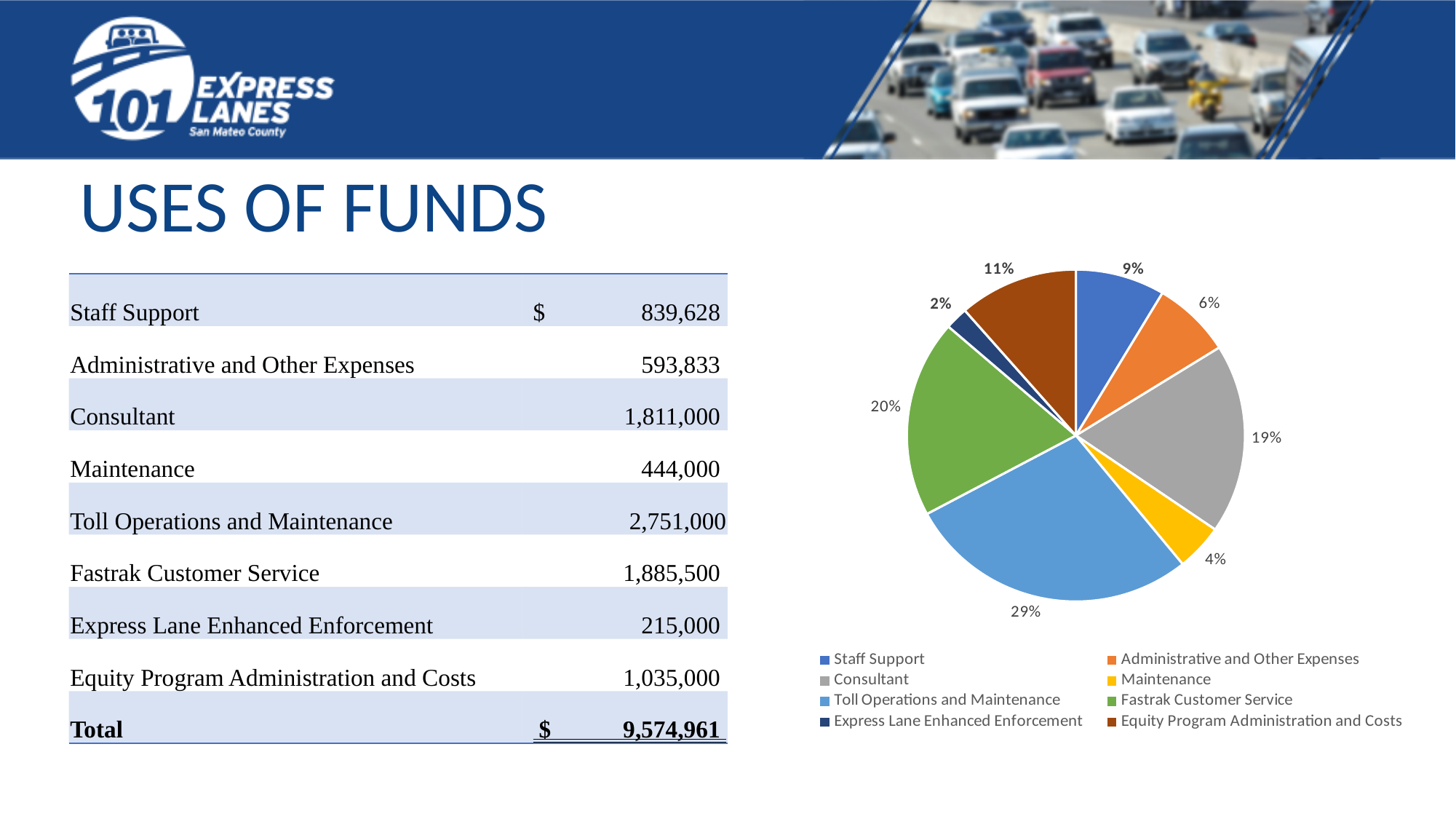
Which category has the largest slice in the pie chart? Toll Operations and Maintenance What share of the pie chart does Toll Operations and Maintenance represent? 29% Which category has the smallest slice in the pie chart? Express Lane Enhanced Enforcement What share of the pie chart does Maintenance represent? 4% What kind of chart is shown on the slide? Pie chart What is the difference in percentage points between the Toll Operations and Maintenance slice and the Fastrak Customer Service slice? 9 What colour is the Maintenance slice in the pie chart? Yellow How many categories does the pie chart's legend list? 8 What share of the pie chart does Equity Program Administration and Costs represent? 11% Which slice is larger in the pie chart, Fastrak Customer Service or Consultant? Fastrak Customer Service